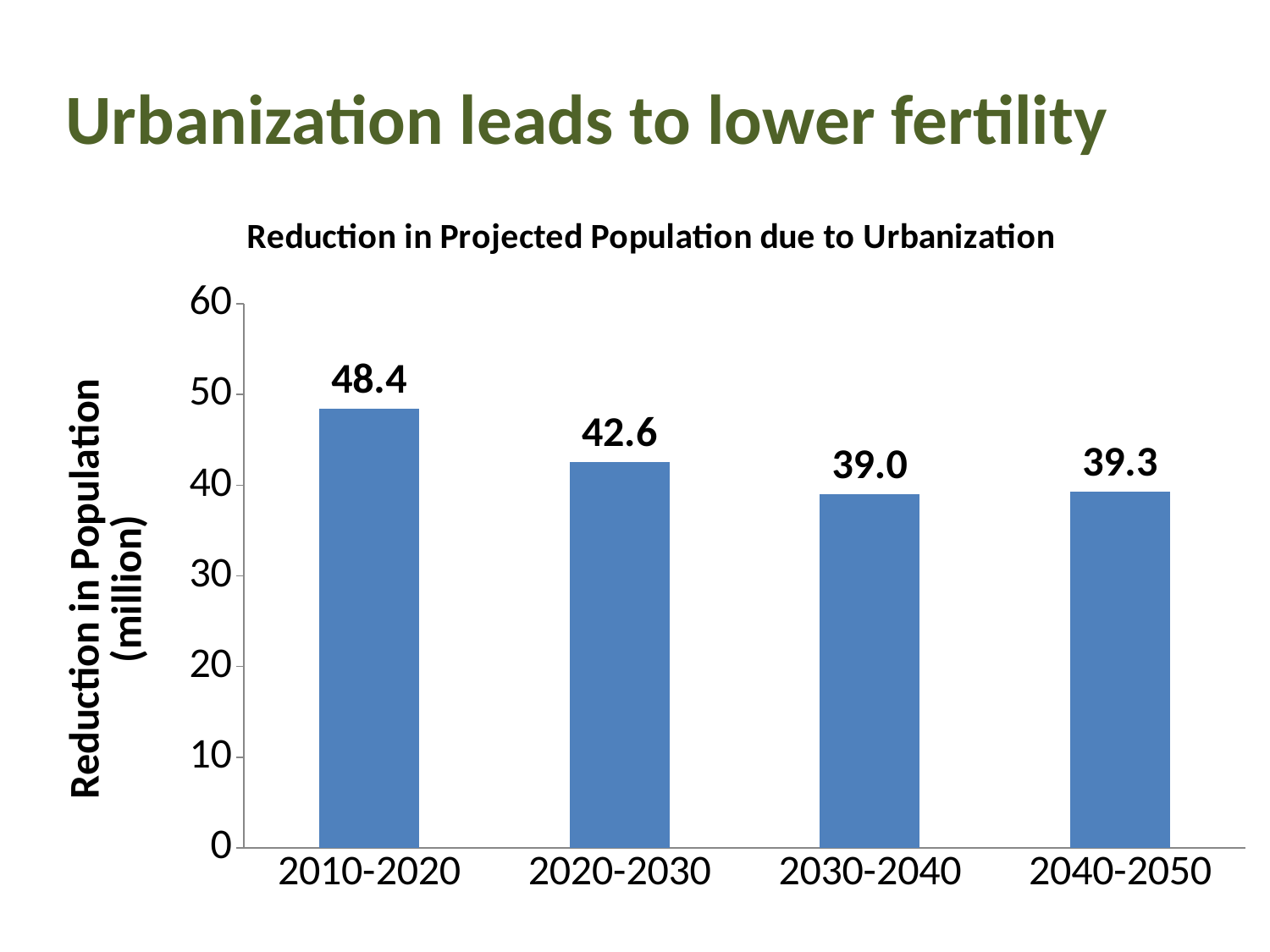
What is the reduction in population for 2020-2030? 42.6 How many periods are shown on the x axis? 4 What is the reduction in population for 2010-2020? 48.4 Which period has the highest reduction in population? 2010-2020 What kind of chart is shown on the slide? bar chart What is the reduction in population for 2030-2040? 39.0 What is the difference between the reduction for 2010-2020 and 2020-2030? 5.8 What is the title of the chart? Reduction in Projected Population due to Urbanization Which is larger, the reduction for 2010-2020 or for 2040-2050? 2010-2020 What is the reduction in population for 2040-2050? 39.3 Which period has the lowest reduction in population? 2030-2040 Is the value for 2020-2030 greater or less than 40? greater